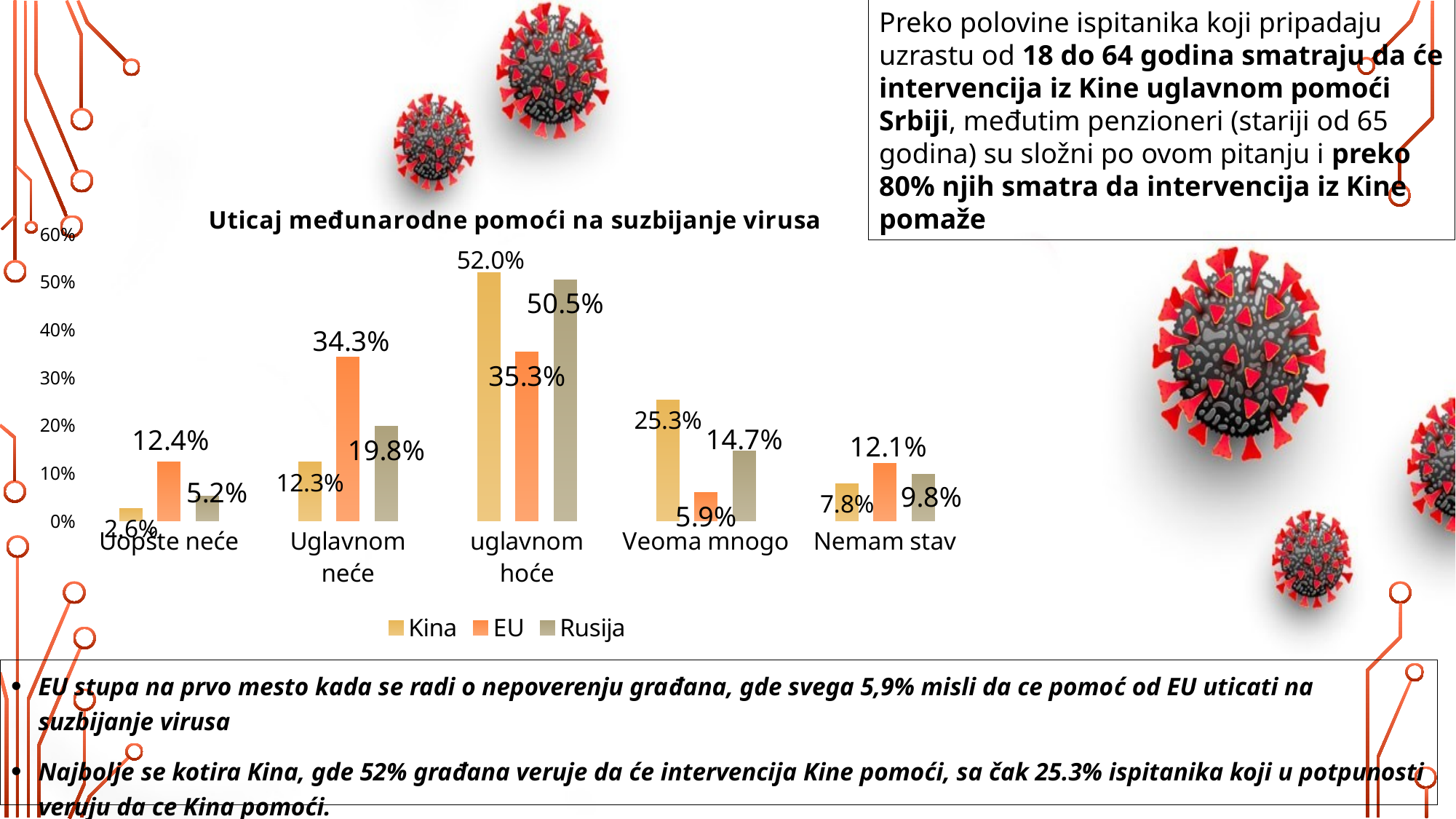
Which category has the lowest value for the Kina series? Uopšte neće How many series does the chart legend list? 3 What type of chart is shown on the slide? Bar chart What is the value for Kina in the 'uglavnom hoće' category? 52.0% Which category has the highest value for the Kina series? uglavnom hoće What is the value for EU in the 'Veoma mnogo' category? 5.9% In the 'Nemam stav' category, which series has the larger value, EU or Rusija? EU What is the value for Rusija in the 'Uglavnom neće' category? 19.8% What is the difference between the Kina and EU values in the 'Uglavnom neće' category? 22.0% Is the value for Rusija in the 'uglavnom hoće' category greater or less than 40%? greater How many categories are shown on the x axis of the chart? 5 What is the title of the chart? Uticaj međunarodne pomoći na suzbijanje virusa